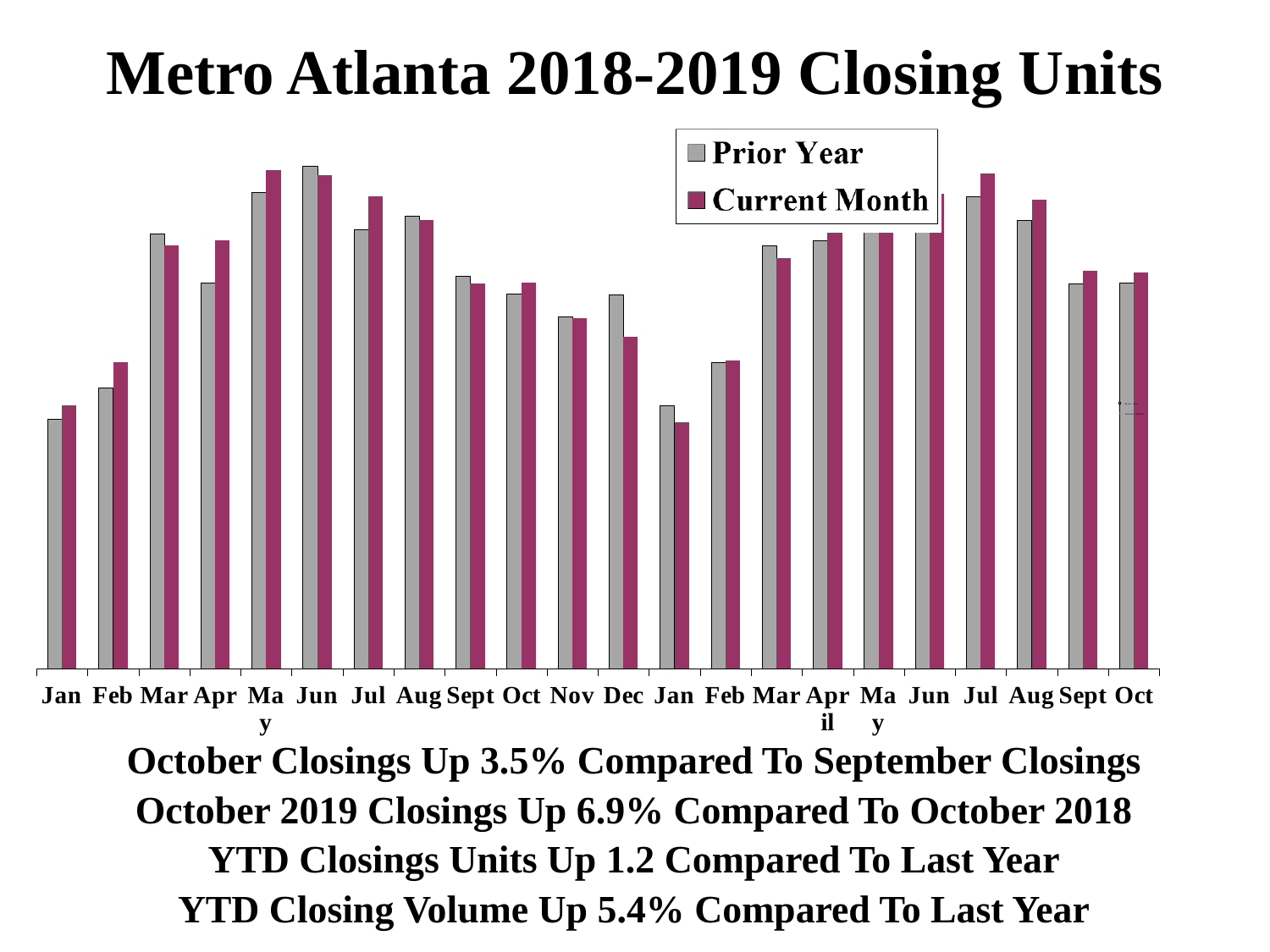
For the first Jan, which is larger: Prior Year or Current Month? Current Month What kind of chart is shown on the slide? Bar chart What is the title of the chart? Metro Atlanta 2018-2019 Closing Units How many series does the legend list? 2 Which month has the lowest Current Month bar? Jan (the second Jan) What are the two series named in the legend? Prior Year and Current Month How many months are shown along the x axis? 22 Which month has the lowest Prior Year bar? Jan (the first Jan) For the first Dec, which is larger: Prior Year or Current Month? Prior Year Which month has the highest Prior Year bar? Jun (the first Jun) Do the Current Month bars rise or fall from the second Jan to the second Jul? Rise Do the Prior Year bars rise or fall from the first Jun to the first Dec? Fall